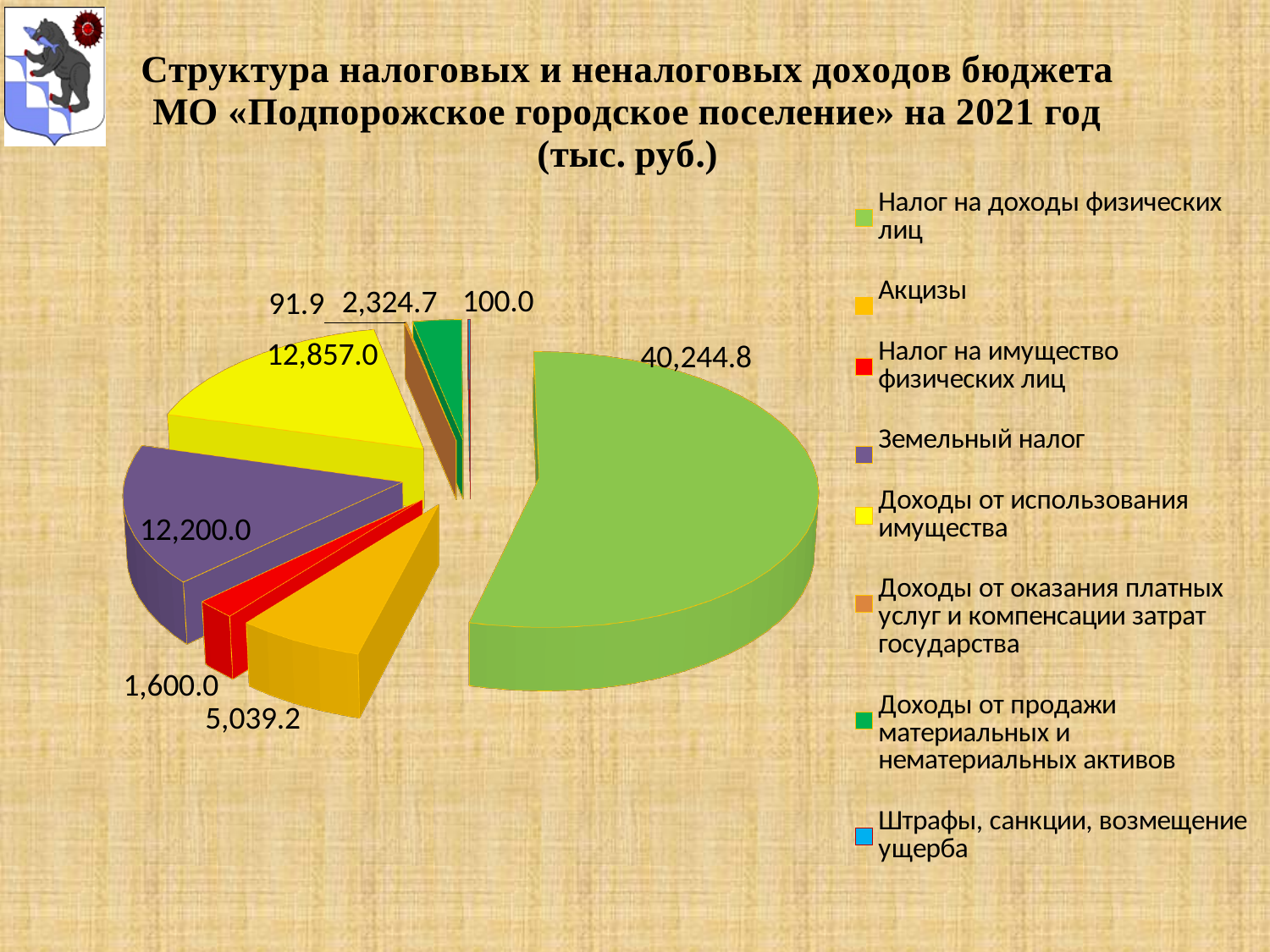
Which category has the largest slice of the pie? Налог на доходы физических лиц What type of chart is shown on the slide? pie chart What is the value for «Доходы от использования имущества»? 12,857.0 How many categories does the legend of the pie chart list? 8 What is the difference between «Доходы от использования имущества» and «Земельный налог»? 657.0 What is the value for «Земельный налог»? 12,200.0 What is the value for «Акцизы»? 5,039.2 Which category has the smallest value? Доходы от оказания платных услуг и компенсации затрат государства What colour is the slice for «Земельный налог»? purple Which is larger: «Акцизы» or «Налог на имущество физических лиц»? Акцизы What is the value for «Штрафы, санкции, возмещение ущерба»? 100.0 What is the value for «Налог на доходы физических лиц»? 40,244.8